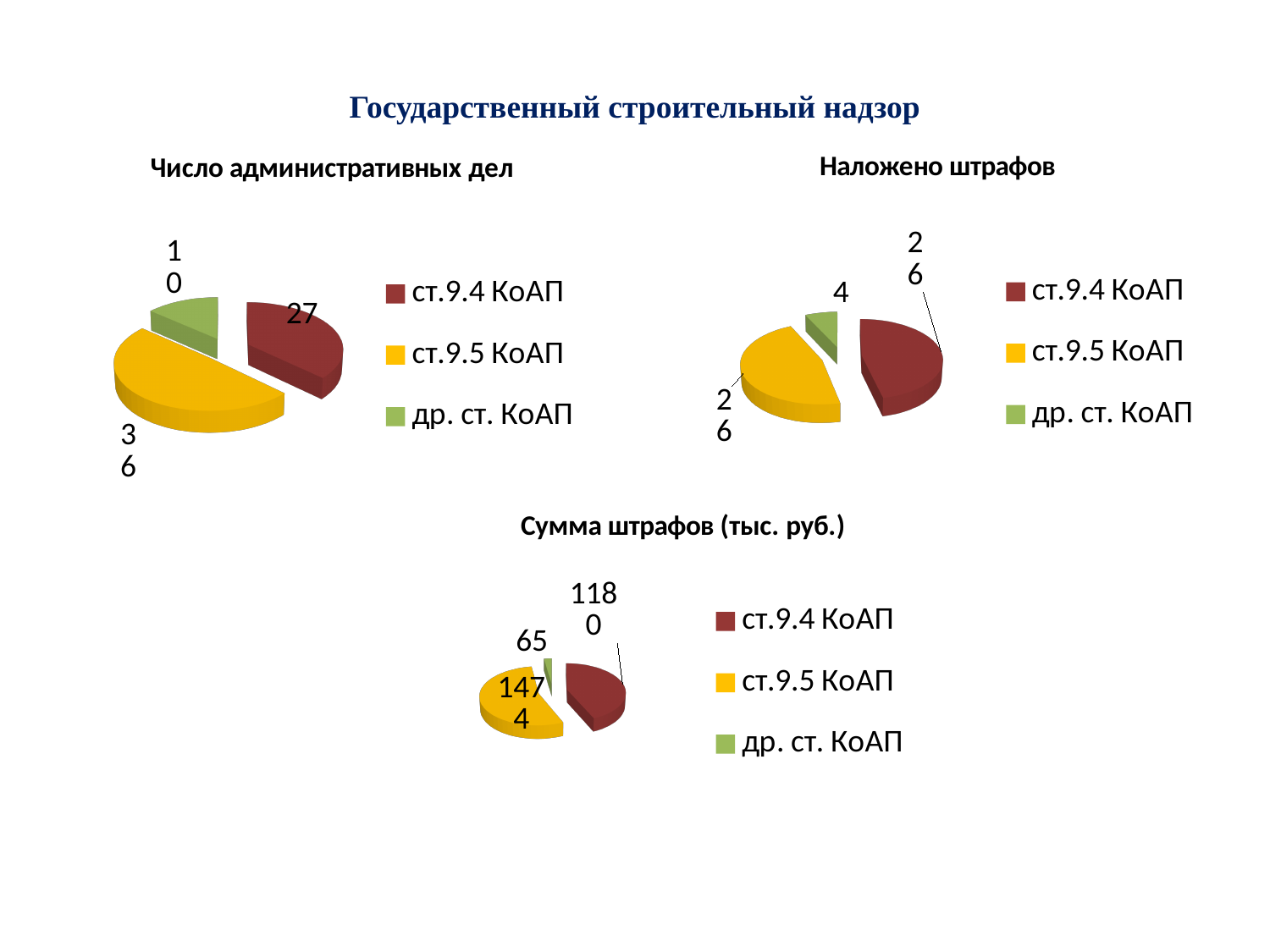
In the chart titled "Сумма штрафов (тыс. руб.)", which category has the largest slice? ст.9.5 КоАП In the chart titled "Число административных дел", which category has the smallest slice? др. ст. КоАП In the chart titled "Наложено штрафов", how many slices does the pie have? 3 In the chart titled "Число административных дел", what is the value for ст.9.4 КоАП? 27 In the chart titled "Наложено штрафов", what is the value for др. ст. КоАП? 4 In the chart titled "Наложено штрафов", what is the value for ст.9.5 КоАП? 26 In the chart titled "Сумма штрафов (тыс. руб.)", what is the value for ст.9.4 КоАП? 1180 In the chart titled "Число административных дел", what is the difference between the values for ст.9.5 КоАП and ст.9.4 КоАП? 9 In the chart titled "Число административных дел", what is the value for ст.9.5 КоАП? 36 In the chart titled "Сумма штрафов (тыс. руб.)", what is the value for ст.9.5 КоАП? 1474 In the chart titled "Сумма штрафов (тыс. руб.)", which is larger: the value for ст.9.4 КоАП or the value for др. ст. КоАП? ст.9.4 КоАП What kind of chart is the chart titled "Число административных дел"? Pie chart